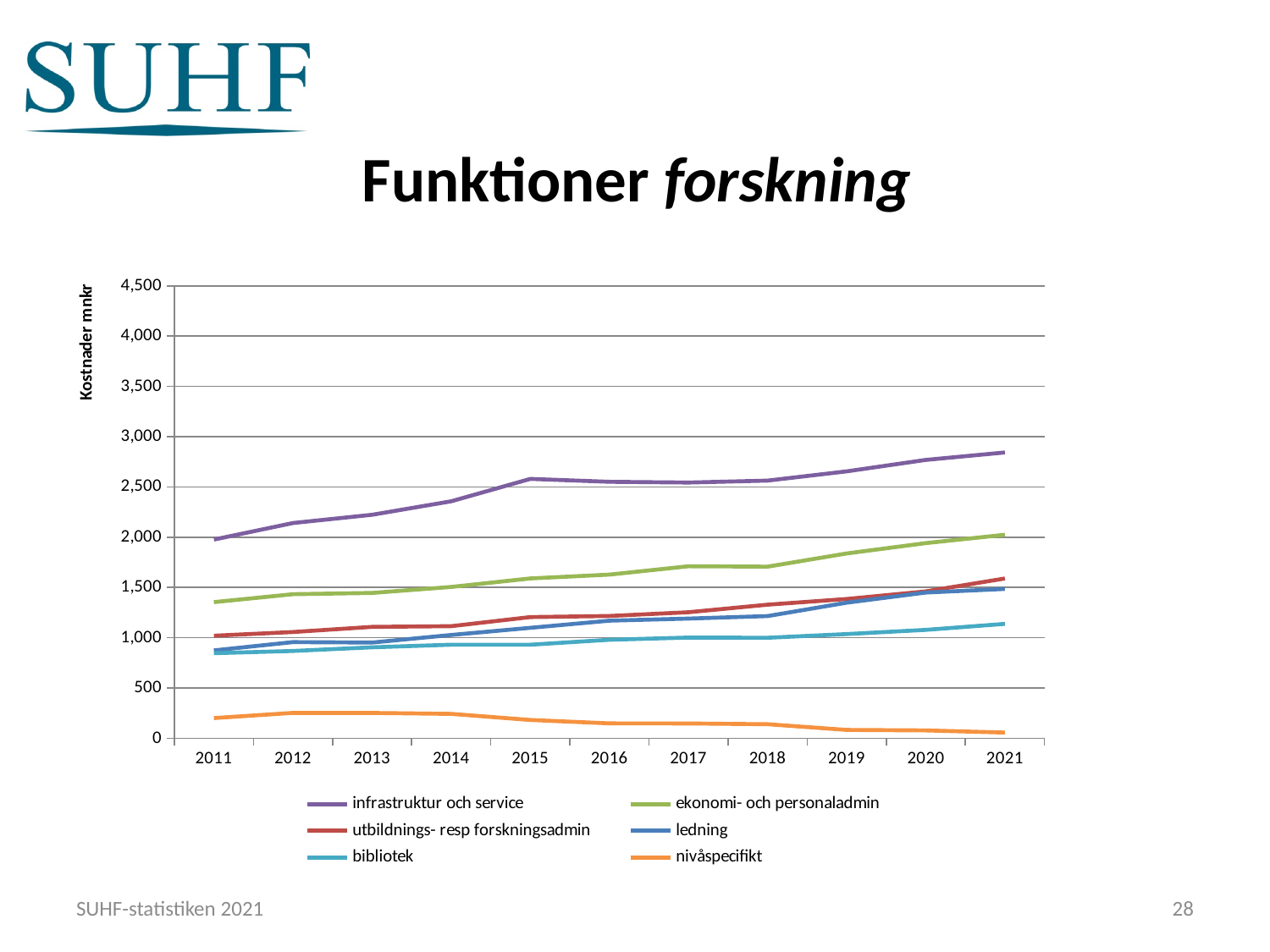
Is the value for infrastruktur och service in 2021 greater or less than 2,500? greater Is the value for nivåspecifikt in 2021 greater or less than 500? less Is the value for ekonomi- och personaladmin in 2011 greater or less than 1,500? less Which series has the lowest values across the whole period? nivåspecifikt What kind of chart is shown on the slide? line chart Does the nivåspecifikt series rise or fall from 2011 to 2021? fall In 2021, which is larger: infrastruktur och service or ekonomi- och personaladmin? infrastruktur och service What is the label on the y axis? Kostnader mnkr How many years are shown along the x axis? 11 Which series has the highest values across the whole period? infrastruktur och service How many series does the legend list? 6